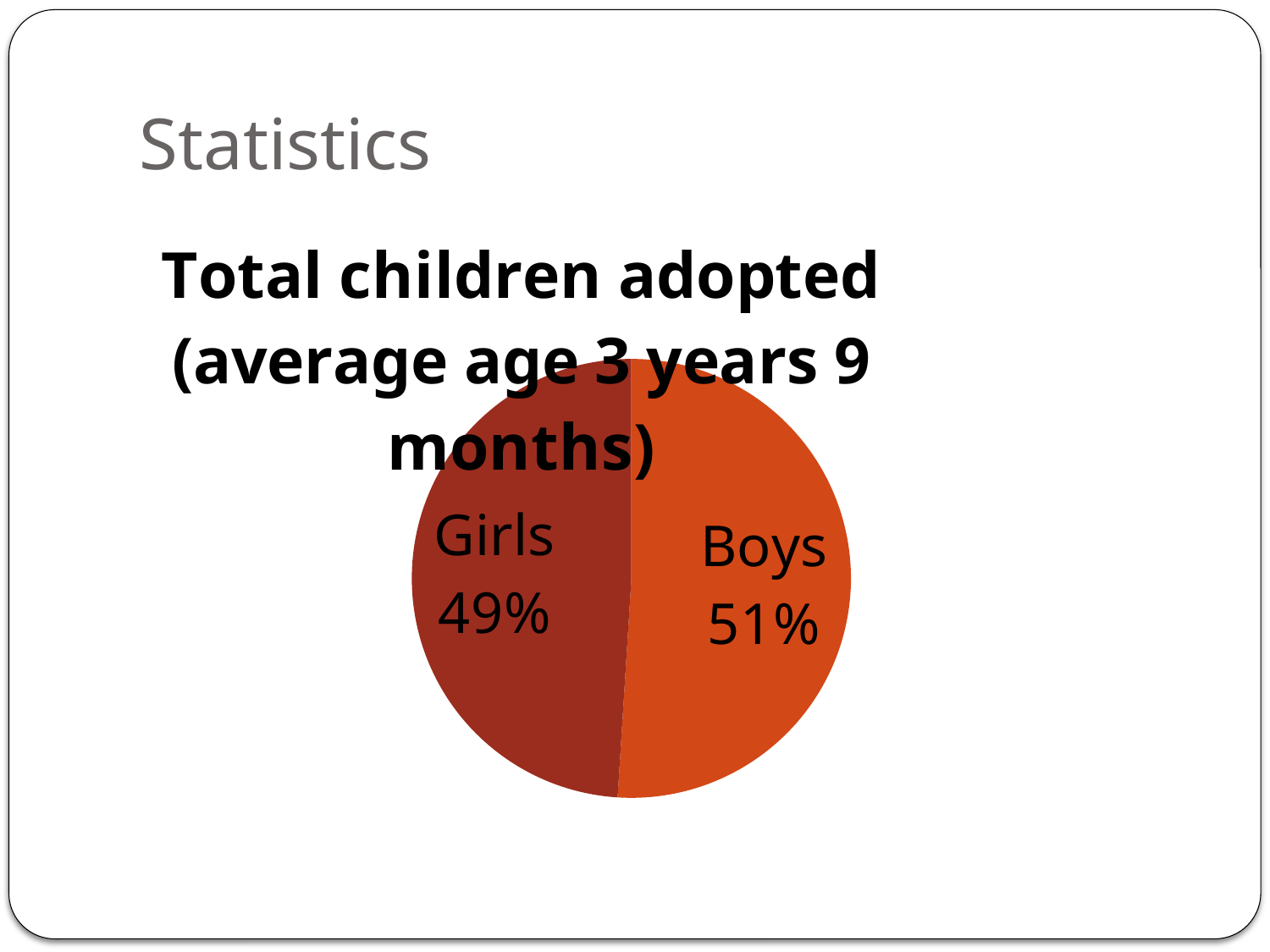
What is the title of the pie chart? Total children adopted (average age 3 years 9 months) What is the combined share of the Girls and Boys slices? 100% Which category has the largest share of the pie chart? Boys What percentage of the pie chart is Boys? 51% Which category has the smallest share of the pie chart? Girls What kind of chart is shown on the slide? pie chart How many slices does the pie chart have? 2 Which slice of the pie chart is larger, Girls or Boys? Boys What is the average age of the adopted children according to the chart title? 3 years 9 months What percentage of the pie chart is Girls? 49% What is the difference in percentage points between the Boys and Girls slices? 2